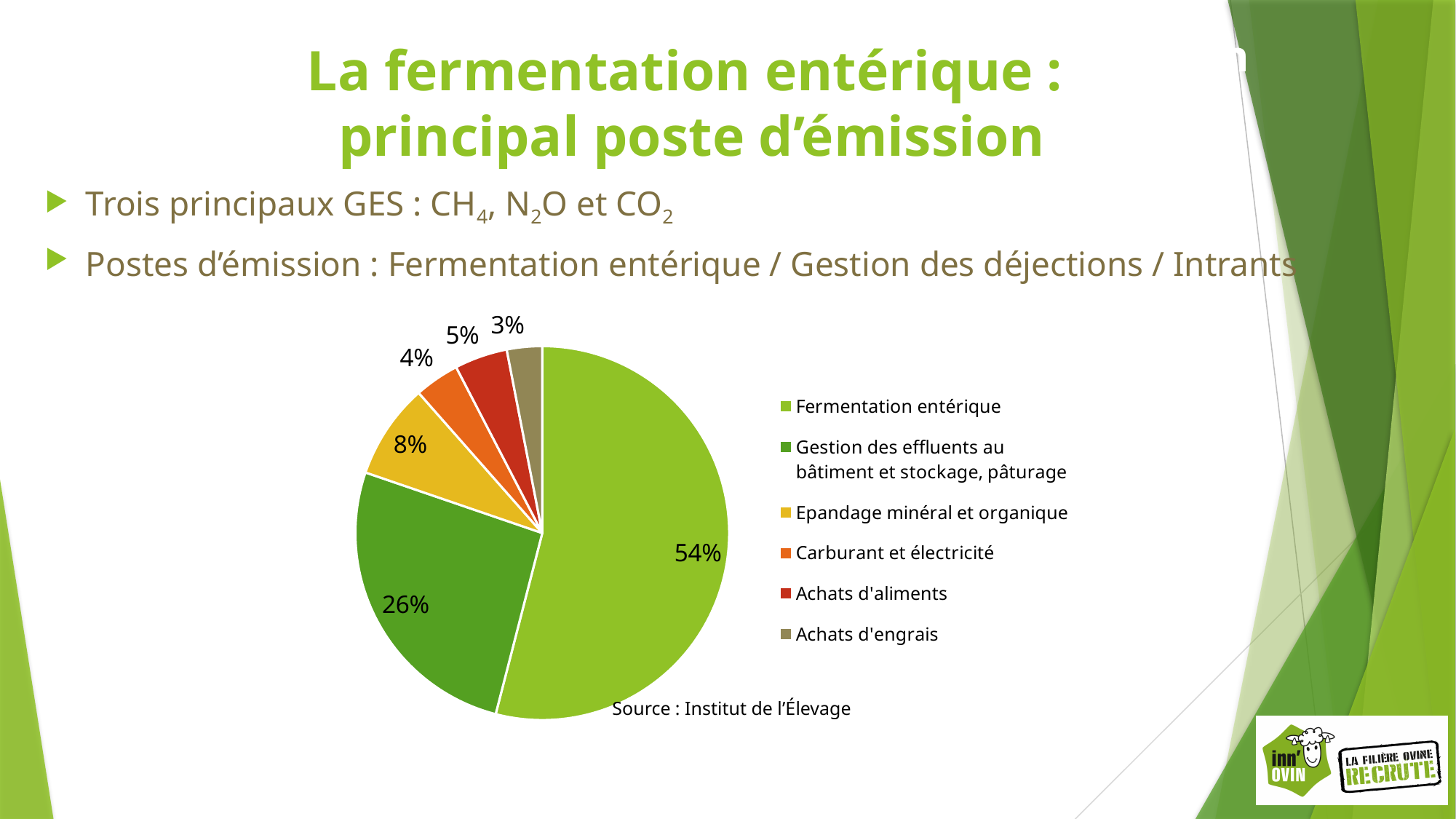
What share of emissions does Fermentation entérique account for in the pie chart? 54% Which category has the smallest slice of the pie chart? Achats d'engrais Which is larger: Carburant et électricité or Achats d'aliments? Achats d'aliments What percentage is shown for Epandage minéral et organique? 8% What source is cited below the pie chart? Institut de l'Élevage What percentage is shown for Gestion des effluents au bâtiment et stockage, pâturage? 26% Which category has the largest slice of the pie chart? Fermentation entérique What percentage is shown for Achats d'aliments? 5% What is the difference in percentage points between Fermentation entérique and Gestion des effluents au bâtiment et stockage, pâturage? 28 What percentage is shown for Achats d'engrais? 3% How many categories does the legend of the pie chart list? 6 What kind of chart is shown on the slide? pie chart